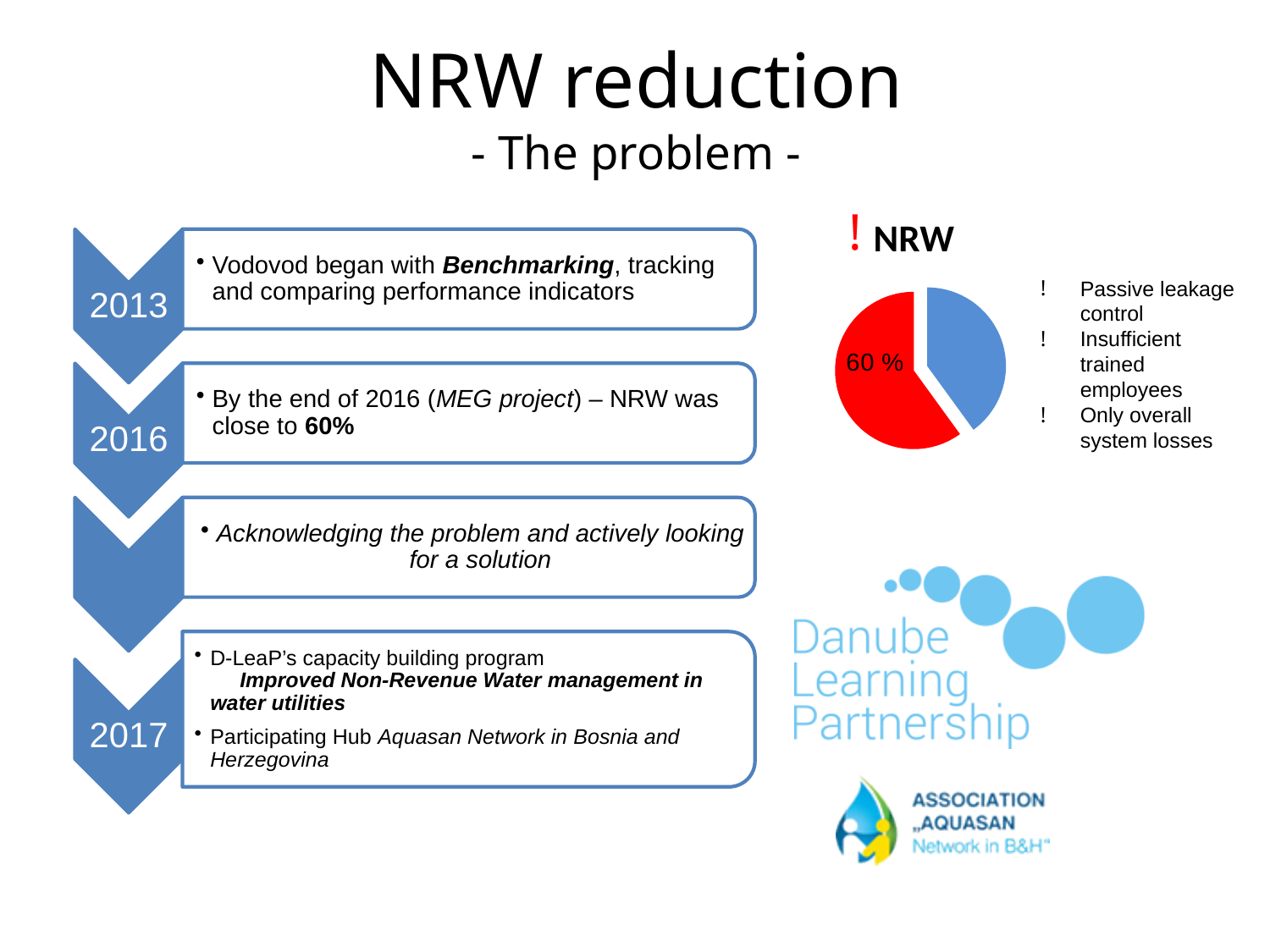
Which slice of the pie chart is larger, the red one or the blue one? the red one Which slice of the pie chart is the smallest? the blue slice What two colours are used for the slices of the pie chart? red and blue What kind of chart is shown on the slide? pie chart What value is printed on the red slice of the pie chart? 60 % How many slices does the pie chart have? 2 What share of the pie does the red slice represent? 60 % What is the title of the pie chart? NRW Which slice of the pie chart is the largest? the red slice (60 %)